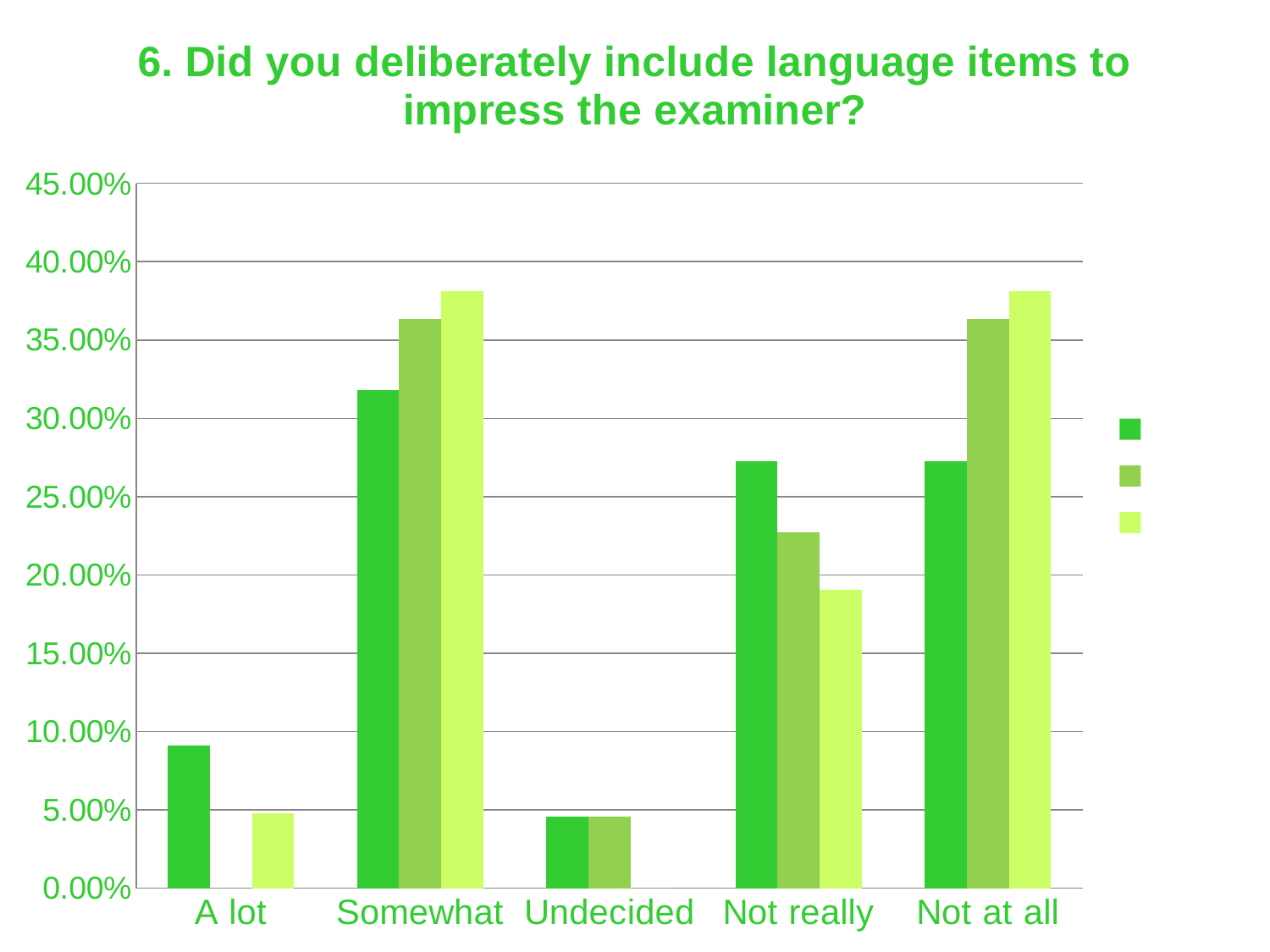
Which category has the highest dark green bar? Somewhat How many response categories are shown on the x axis? 5 Which is larger: the dark green bar for Somewhat or the dark green bar for Not at all? Somewhat Is the dark green bar for A lot greater or less than 10.00%? less What is the title of the chart? 6. Did you deliberately include language items to impress the examiner? What kind of chart is shown on the slide? bar chart Is the light green bar for Not really greater or less than 20.00%? less For Not really, which is larger: the dark green bar or the light green bar? dark green Which category has the lowest dark green bar? Undecided Is the medium green bar for Not at all greater or less than 35.00%? greater How many series does the legend list? 3